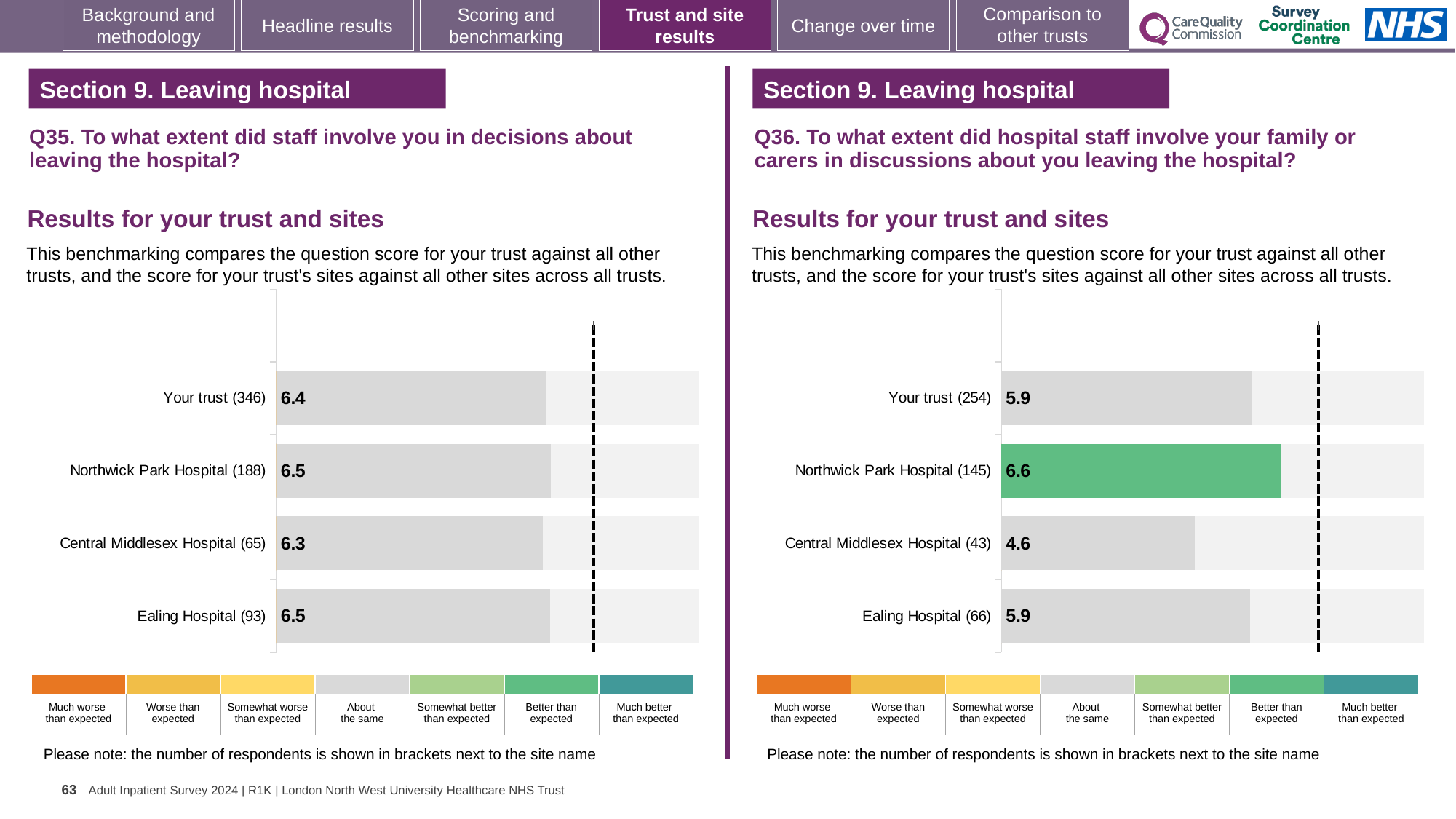
In the Q36 chart on the right, which has the larger score, Your trust or Northwick Park Hospital? Northwick Park Hospital What kind of chart is used for the Q36 results on the right? Bar chart How many bars are plotted in the Q35 chart on the left? 4 In the Q35 chart on the left, which site has the lowest score? Central Middlesex Hospital In the Q36 chart on the right, what is the score for Ealing Hospital? 5.9 In the Q36 chart on the right, how many respondents are shown in brackets for Your trust? 254 In the Q35 chart on the left, what is the score for Central Middlesex Hospital? 6.3 In the Q35 chart on the left, what is the score for Your trust? 6.4 In the Q36 chart on the right, which site has the lowest score? Central Middlesex Hospital In the Q36 chart on the right, which site has the highest score? Northwick Park Hospital In the Q36 chart on the right, what is the difference between the scores for Northwick Park Hospital and Central Middlesex Hospital? 2.0 In the Q36 chart on the right, what is the score for Northwick Park Hospital? 6.6